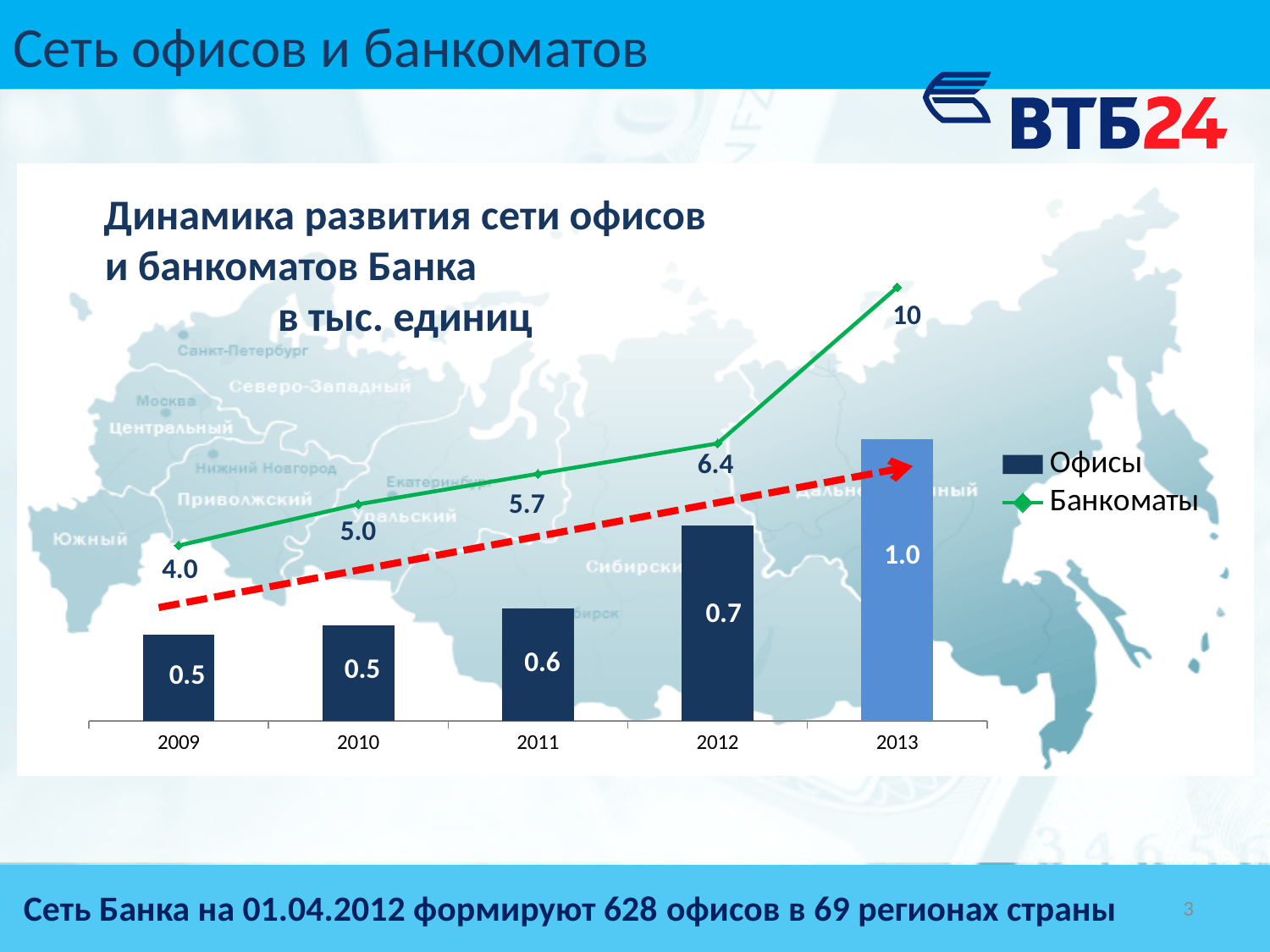
Do the Банкоматы values rise or fall from 2009 to 2013? rise In which year is the Офисы value highest? 2013 Which is larger, the Банкоматы value in 2010 or in 2012? 2012 What is the value for Банкоматы in 2009? 4.0 What is the value for Офисы in 2013? 1.0 How many years are shown on the x axis? 5 How many series does the legend list? 2 What is the difference between the Банкоматы values for 2013 and 2012? 3.6 What is the difference between the Офисы values for 2013 and 2009? 0.5 What is the value for Банкоматы in 2011? 5.7 In which year is the Банкоматы value highest? 2013 Which series is shown as a green line in the chart? Банкоматы